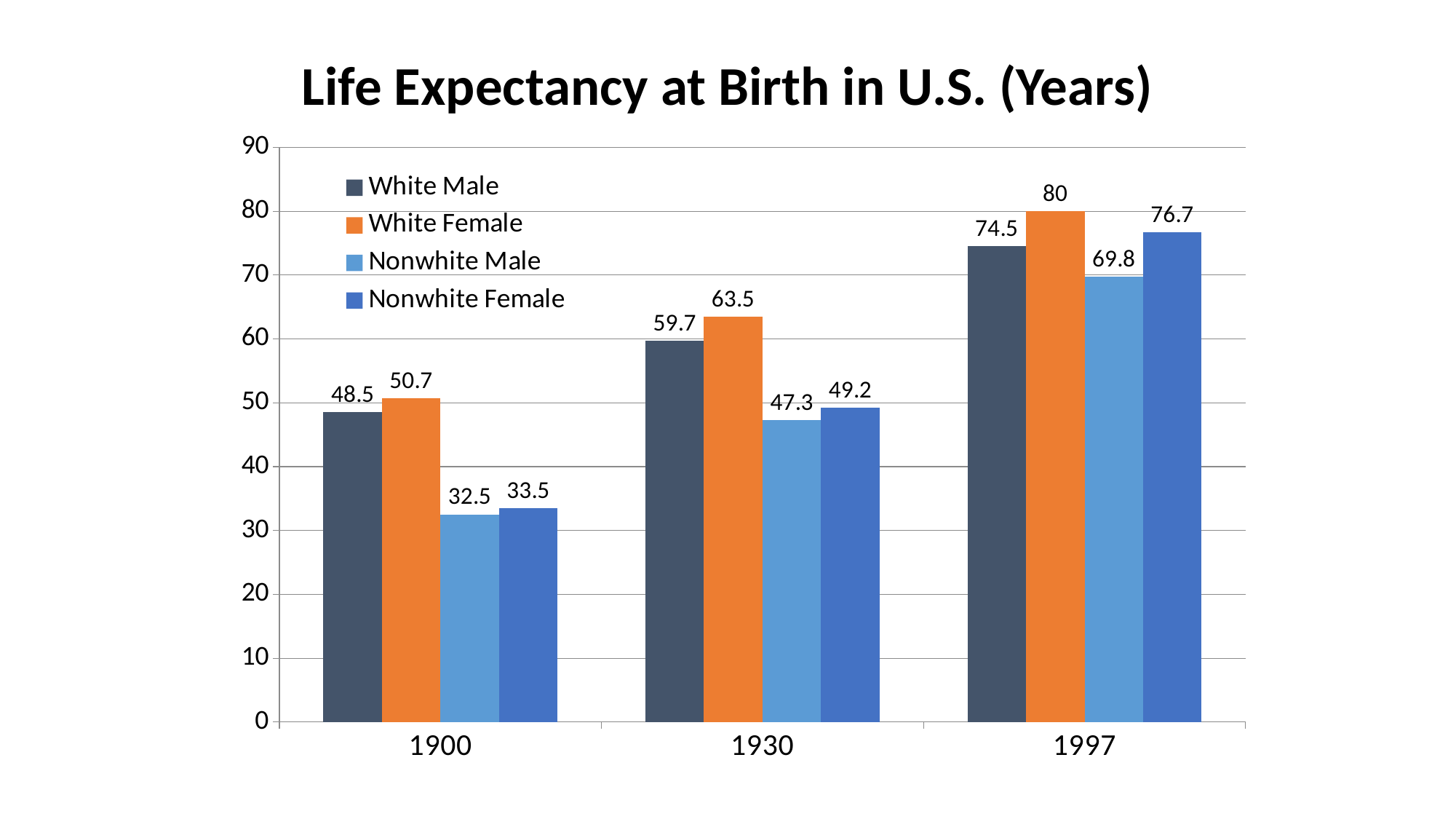
What is the title of the chart? Life Expectancy at Birth in U.S. (Years) Do the White Male values rise or fall from 1900 to 1997? Rise Which series has the highest value in 1997? White Female Which is larger: White Male in 1930 or Nonwhite Female in 1997? Nonwhite Female in 1997 Which series has the lowest value in 1900? Nonwhite Male What is the life expectancy for White Male in 1930? 59.7 How many year categories are shown on the x axis? 3 What kind of chart is this? Bar chart What is the difference between White Female and Nonwhite Female in 1930? 14.3 What is the life expectancy for White Female in 1900? 50.7 How many series does the legend list? 4 What is the life expectancy for Nonwhite Male in 1997? 69.8